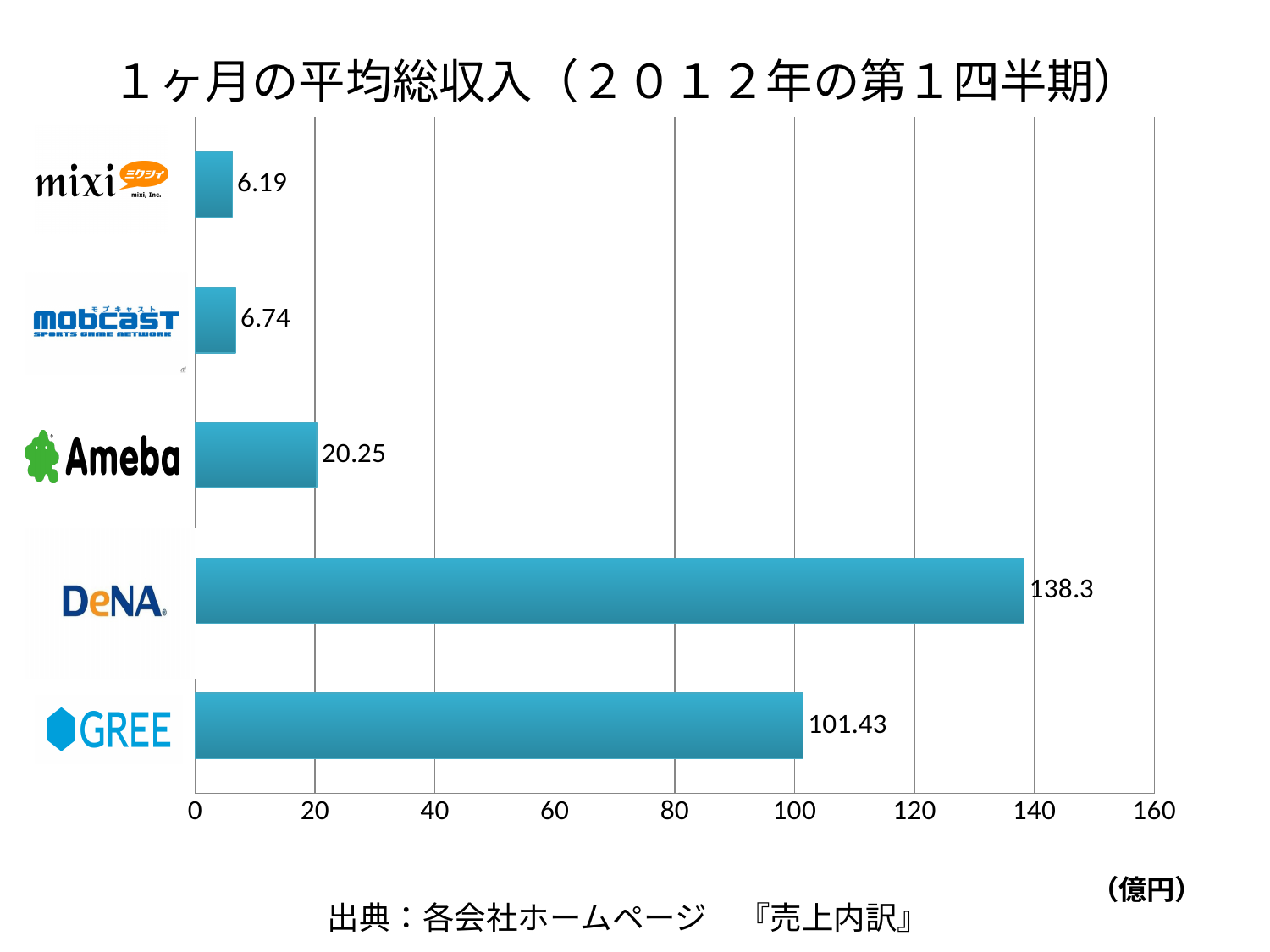
How many companies are shown on the chart? 5 What unit is indicated for the values on the chart? 億円 What is the value shown for mixi? 6.19 Which company has the lowest value on the chart? mixi What is the difference between the values for DeNA and GREE? 36.87 Is the value for GREE greater or less than 100? greater What is the value shown for GREE? 101.43 What is the value shown for Ameba? 20.25 Which is larger, the value for Ameba or the value for mobcast? Ameba Which company has the highest value on the chart? DeNA What is the value shown for DeNA? 138.3 What kind of chart is shown on the slide? Bar chart